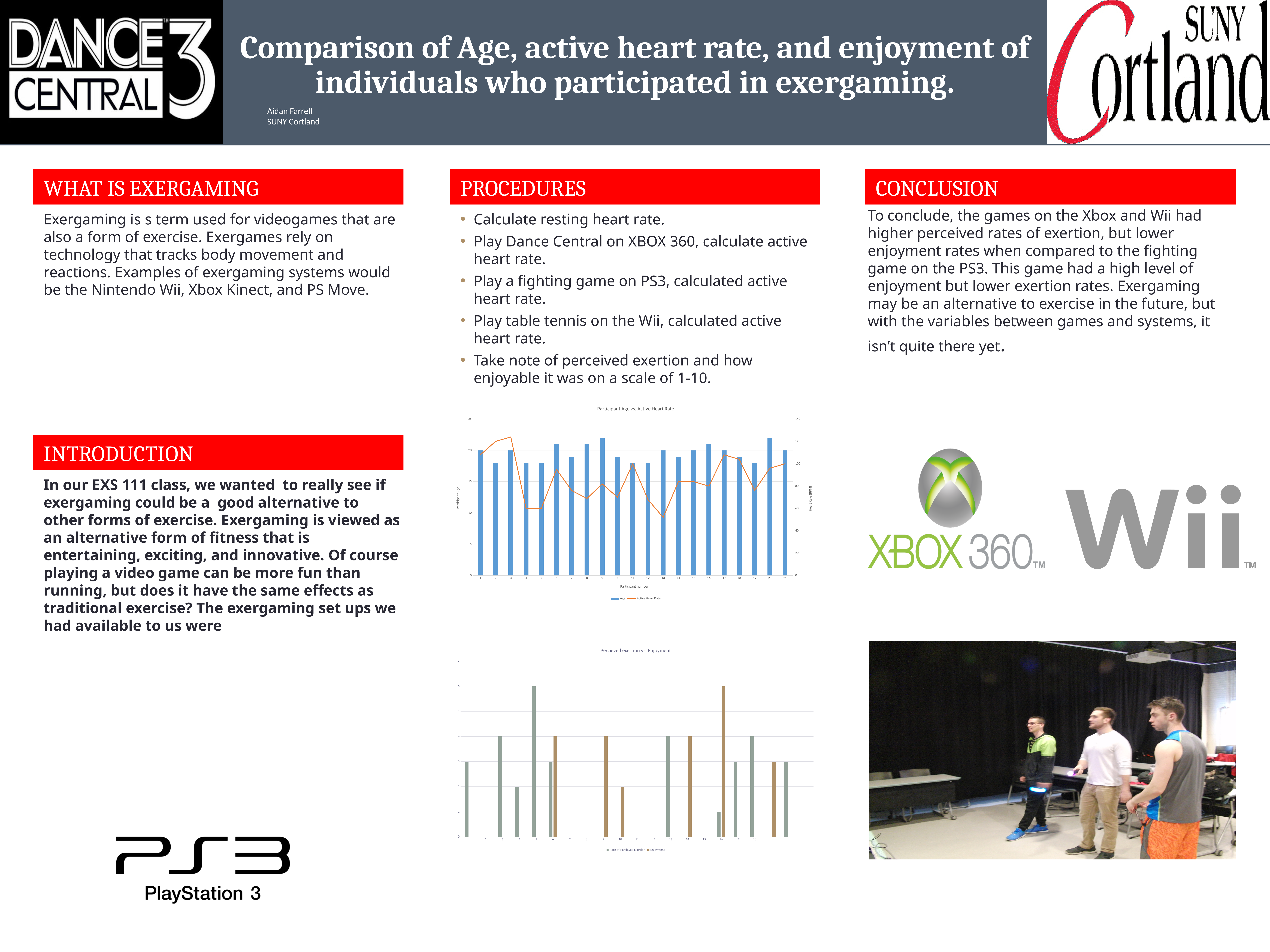
In the 'Percieved exertion vs. Enjoyment' chart, what is the enjoyment value for participant 16? 6 What kind of chart is 'Percieved exertion vs. Enjoyment'? bar chart In the 'Participant Age vs. Active Heart Rate' chart, which participant has the highest active heart rate? 3 In the 'Participant Age vs. Active Heart Rate' chart, is the active heart rate for participant 13 greater or less than 60? less In the 'Participant Age vs. Active Heart Rate' chart, how many series does the legend list? 2 In the 'Participant Age vs. Active Heart Rate' chart, how many participants are plotted on the x axis? 21 In the 'Participant Age vs. Active Heart Rate' chart, is the active heart rate for participant 3 greater or less than 100? greater In the 'Percieved exertion vs. Enjoyment' chart, which participant has the highest rate of perceived exertion? 5 In the 'Percieved exertion vs. Enjoyment' chart, what is the rate of perceived exertion for participant 5? 6 In the 'Participant Age vs. Active Heart Rate' chart, which participant has the lowest active heart rate? 13 In the 'Participant Age vs. Active Heart Rate' chart, is the active heart rate for participant 2 larger or smaller than that for participant 4? larger In the 'Participant Age vs. Active Heart Rate' chart, what are the two legend entries? Age, Active Heart Rate